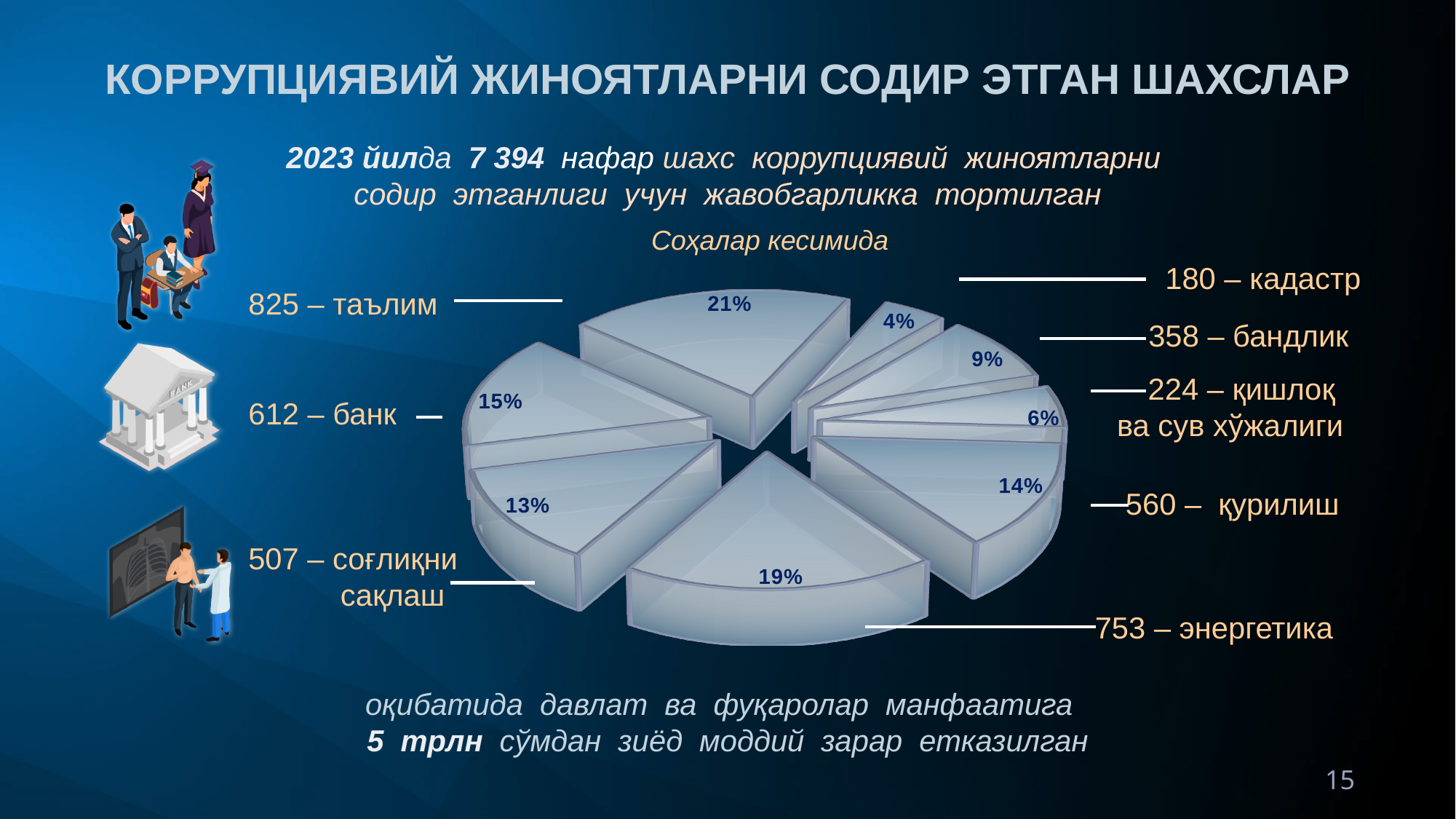
What percentage share does the таълим slice have? 21% What percentage share does the энергетика slice have? 19% What kind of chart is shown on the slide? pie chart What is the difference between the number for таълим and the number for энергетика? 72 What percentage share does the кадастр slice have? 4% How many slices does the pie chart have? 8 What number of persons is shown for қурилиш? 560 Which sector has the largest slice of the pie? таълим What number of persons is shown for банк? 612 What is the title shown above the pie chart? Соҳалар кесимида Which is larger, the number for бандлик or the number for соғлиқни сақлаш? соғлиқни сақлаш Which sector has the smallest slice of the pie? кадастр